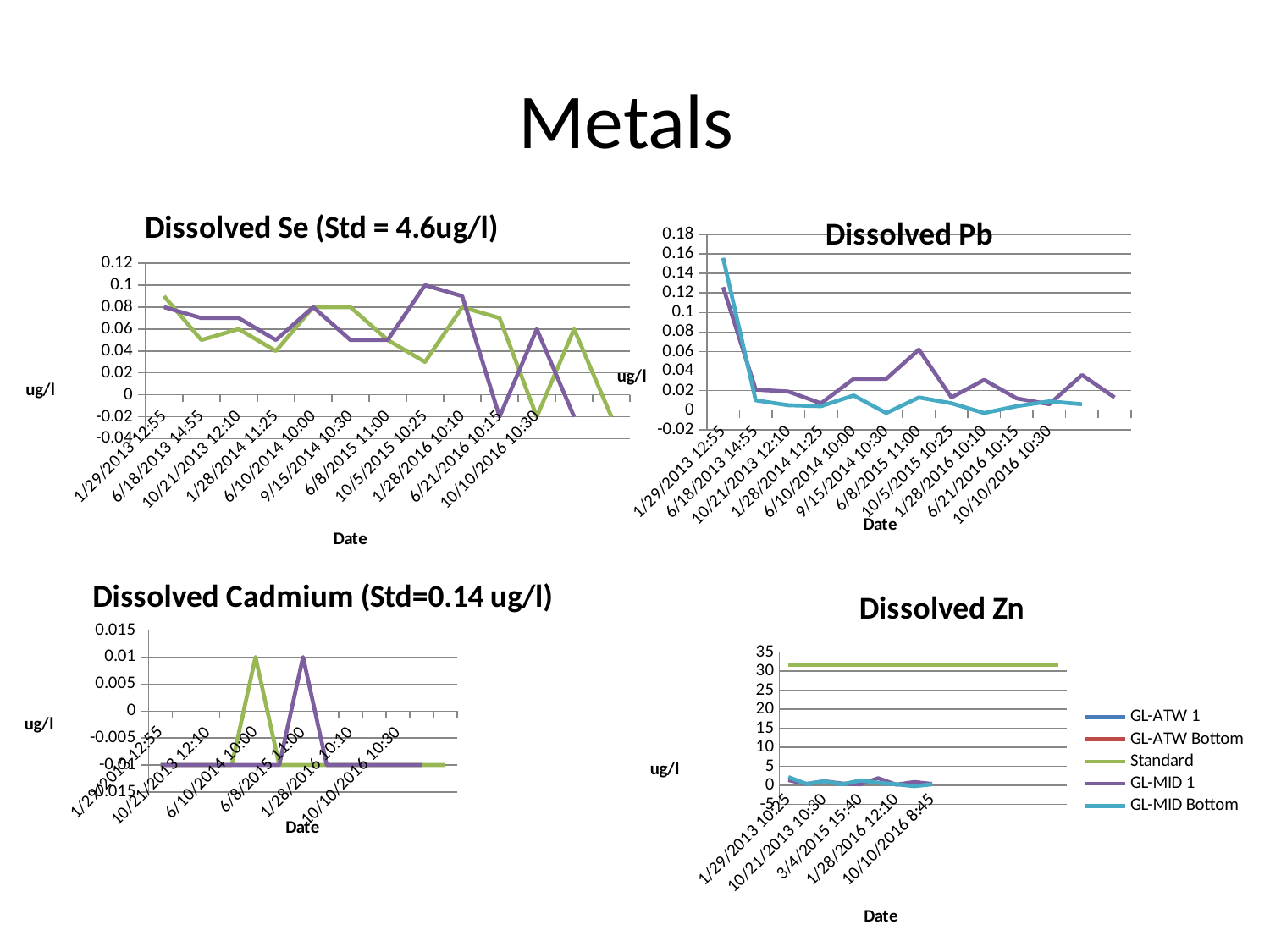
In the Dissolved Pb chart, is the highest plotted value greater or less than 0.1? greater How many series does the legend of the Dissolved Zn chart list? 5 In the Dissolved Se chart, is the highest plotted value greater or less than 0.12? less What kind of chart is the Dissolved Se (Std = 4.6ug/l) chart? line chart What is the y-axis label on the Dissolved Pb chart? ug/l What standard value is given in the title of the Dissolved Se chart? 4.6ug/l In the Dissolved Cadmium (Std=0.14 ug/l) chart, is the highest plotted value greater or less than 0.005? greater In the Dissolved Pb chart, do the values rise or fall between 1/29/2013 12:55 and 6/18/2013 14:55? fall In the Dissolved Zn chart, which series has the larger values, Standard or GL-MID Bottom? Standard How many charts are shown on the slide? 4